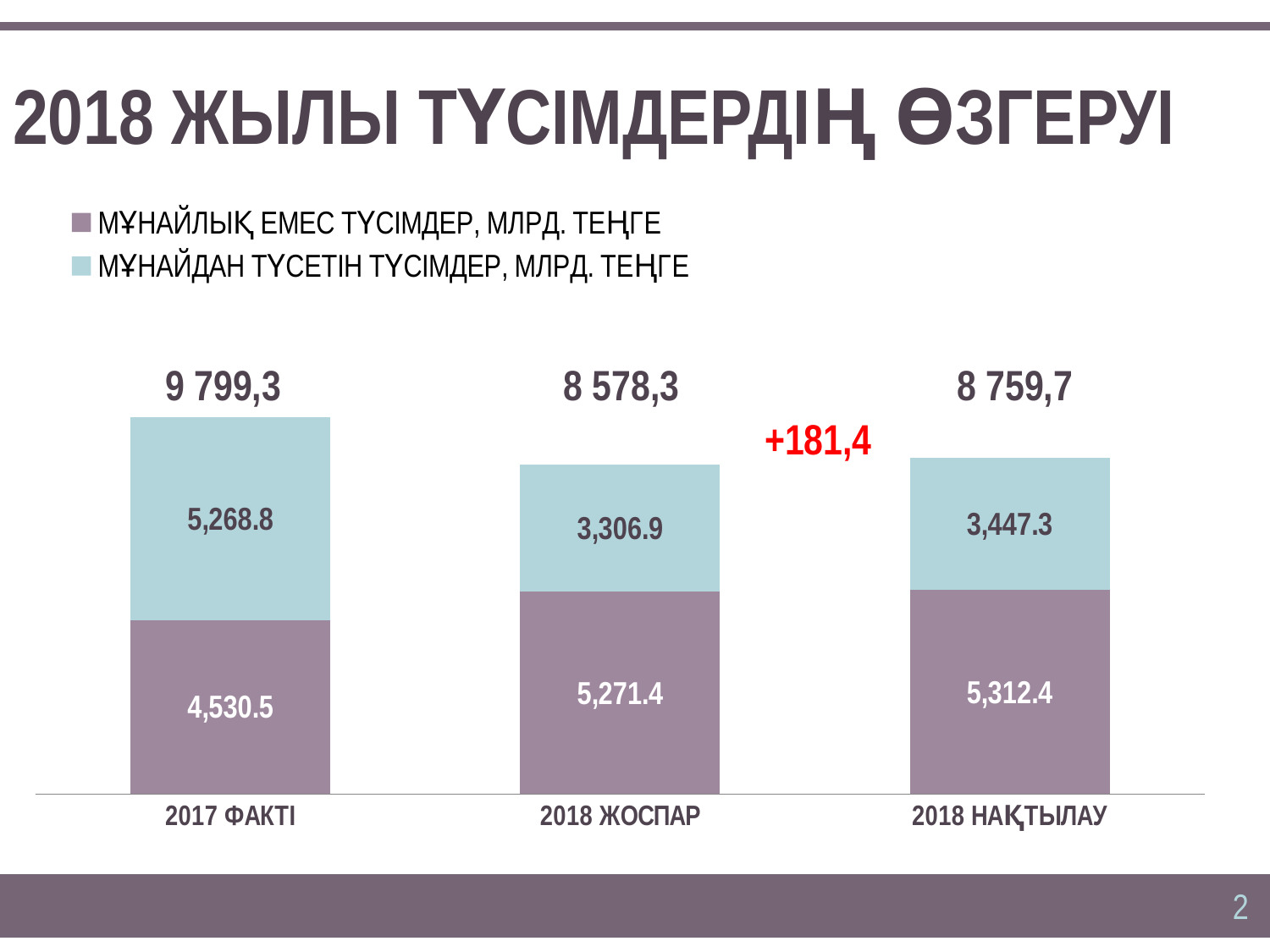
Which is larger for 2017 ФАКТІ: oil revenue or non-oil revenue? Oil revenue (5,268.8) What kind of chart is shown on the slide? Stacked bar chart Which category has the lowest oil revenue (МҰНАЙДАН ТҮСЕТІН ТҮСІМДЕР)? 2018 ЖОСПАР Which category has the highest total revenue? 2017 ФАКТІ How many categories are shown on the x axis? 3 What is the oil revenue (МҰНАЙДАН ТҮСЕТІН ТҮСІМДЕР) value for 2018 ЖОСПАР? 3,306.9 What is the total of the stacked bar for 2017 ФАКТІ? 9 799,3 What is the non-oil revenue (МҰНАЙЛЫҚ ЕМЕС ТҮСІМДЕР) value for 2017 ФАКТІ? 4,530.5 What is the difference between the oil revenue for 2018 НАҚТЫЛАУ and 2018 ЖОСПАР? 140.4 How many series does the legend list? 2 What is the non-oil revenue value for 2018 НАҚТЫЛАУ? 5,312.4 What is the total of the stacked bar for 2018 НАҚТЫЛАУ? 8 759,7